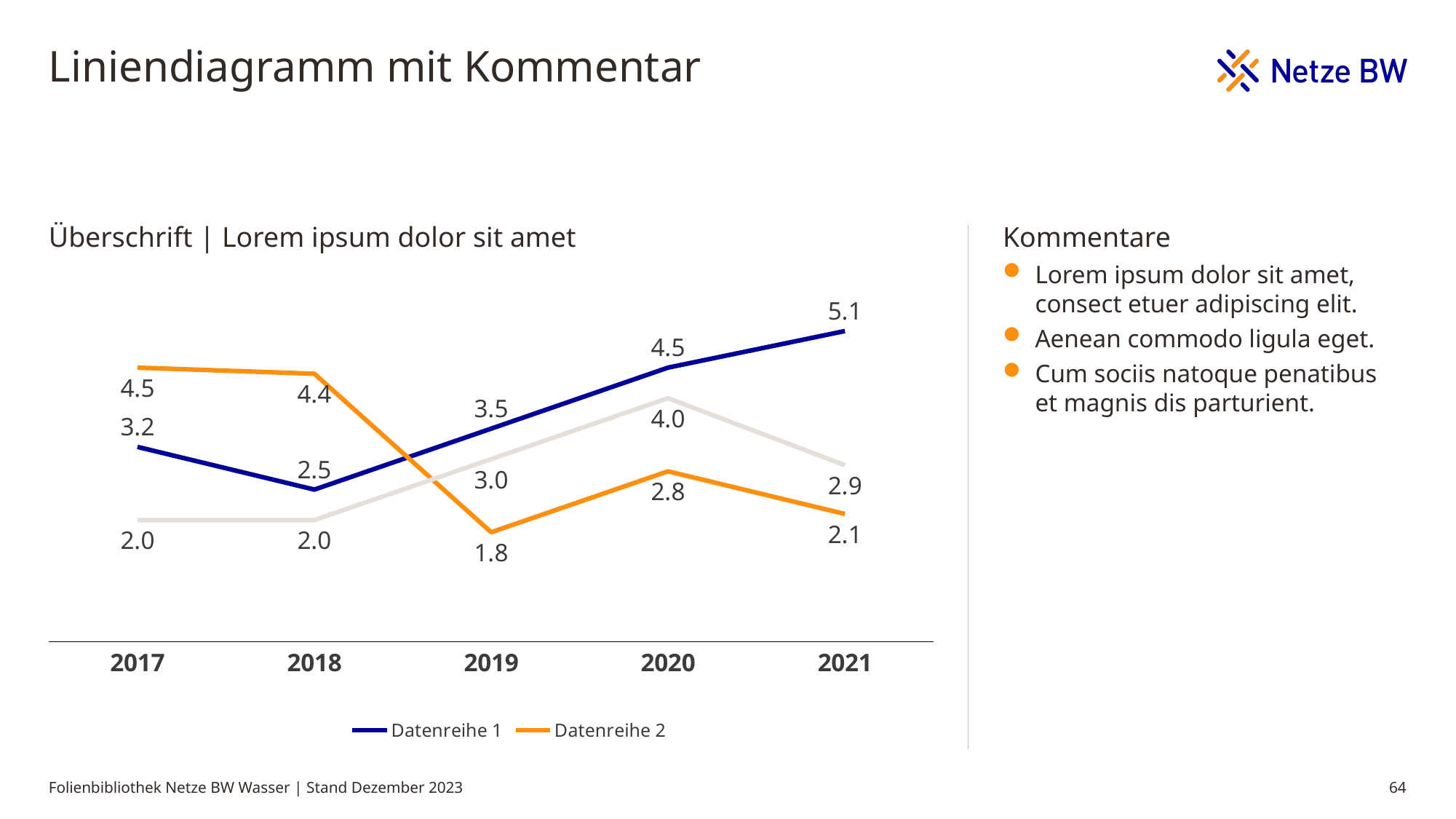
How many years are shown on the x axis? 5 What is the value of Datenreihe 2 in 2019? 1.8 Does Datenreihe 1 rise or fall from 2018 to 2021? rise What is the difference between Datenreihe 1 and Datenreihe 2 in 2021? 3.0 What is the value of Datenreihe 1 in 2021? 5.1 What is the value of Datenreihe 2 in 2017? 4.5 In which year does Datenreihe 2 have its lowest value? 2019 In which year does Datenreihe 1 reach its highest value? 2021 What type of chart is shown on the slide? line chart How many series does the legend list? 2 Which series has the larger value in 2017, Datenreihe 1 or Datenreihe 2? Datenreihe 2 What is the value of Datenreihe 1 in 2018? 2.5